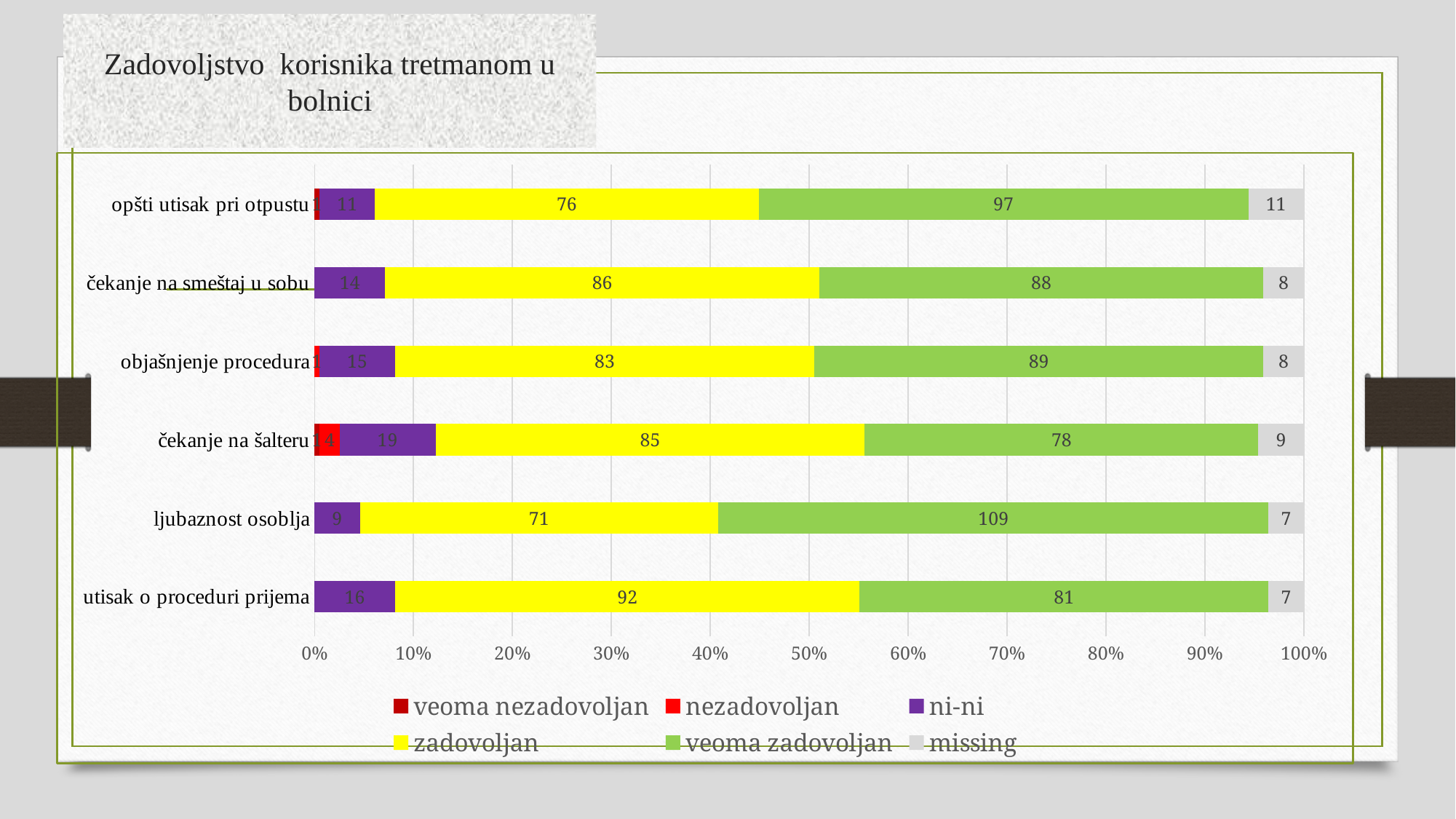
What is the total of all segments in the 'ljubaznost osoblja' bar? 196 Which category has the highest 'veoma zadovoljan' value? ljubaznost osoblja Which category has the lowest 'zadovoljan' value? ljubaznost osoblja How many series does the legend list? 6 What is the difference between the 'zadovoljan' values for 'čekanje na smeštaj u sobu' and 'opšti utisak pri otpustu'? 10 What is the 'missing' value for 'opšti utisak pri otpustu'? 11 What is the value of 'veoma zadovoljan' for 'ljubaznost osoblja'? 109 What is the title of the slide? Zadovoljstvo korisnika tretmanom u bolnici How many categories are shown on the chart? 6 What is the value of 'zadovoljan' for 'utisak o proceduri prijema'? 92 What kind of chart is shown on the slide? stacked bar chart Which has the larger 'ni-ni' value: 'čekanje na šalteru' or 'ljubaznost osoblja'? čekanje na šalteru